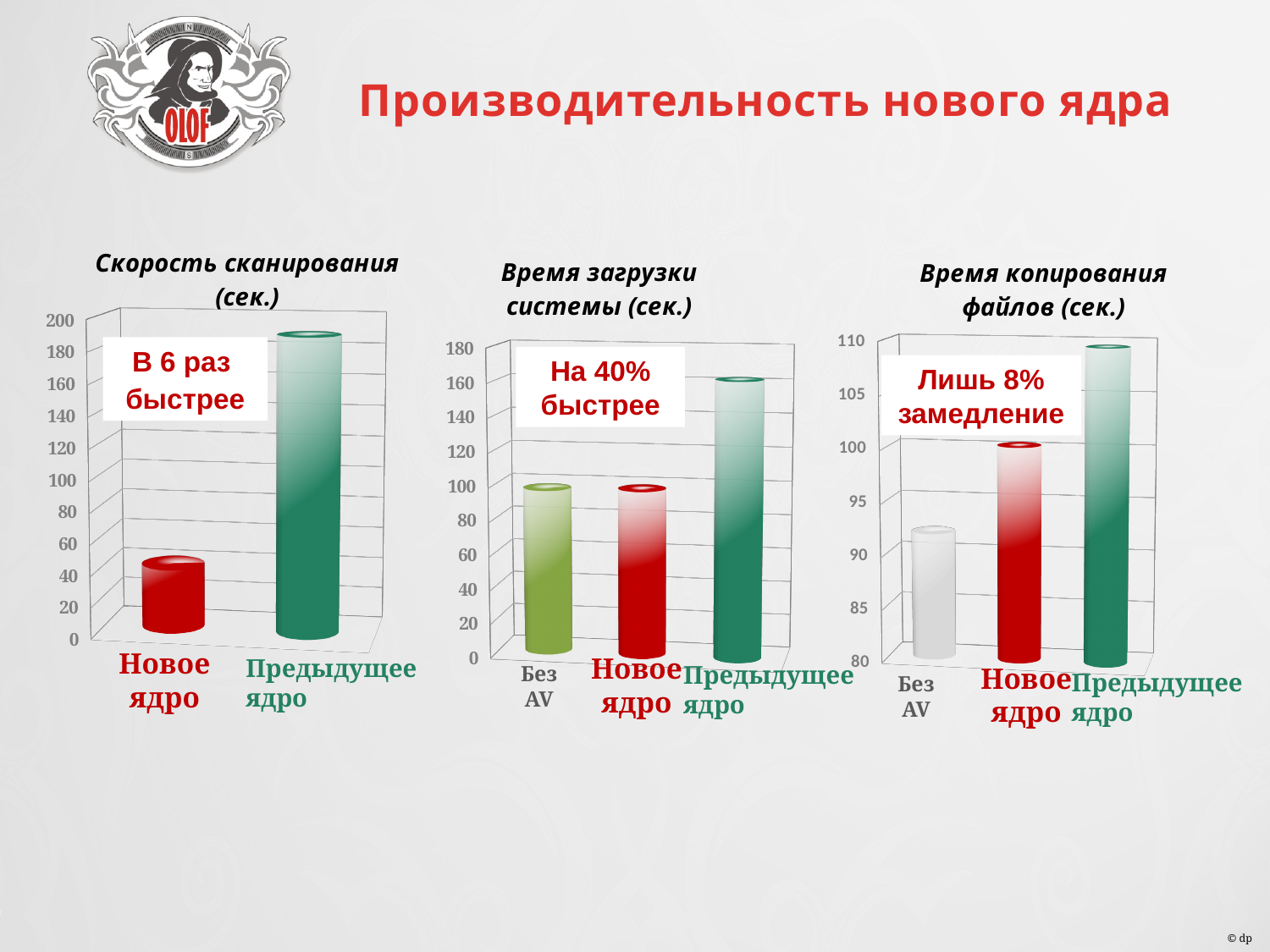
In the 'Время загрузки системы (сек.)' chart, is the value for Без AV greater or less than 140? less In the 'Время копирования файлов (сек.)' chart, which is larger: Новое ядро or Без AV? Новое ядро In the 'Скорость сканирования (сек.)' chart, which category has the highest value? Предыдущее ядро What kind of chart is the 'Скорость сканирования (сек.)' chart? bar chart In the 'Время загрузки системы (сек.)' chart, which category has the highest value? Предыдущее ядро What text is written in the callout box on the 'Скорость сканирования (сек.)' chart? В 6 раз быстрее In the 'Скорость сканирования (сек.)' chart, is the value for Новое ядро greater or less than 100? less How many categories are shown in the 'Время загрузки системы (сек.)' chart? 3 In the 'Скорость сканирования (сек.)' chart, is the value for Предыдущее ядро greater or less than 140? greater How many categories are shown in the 'Скорость сканирования (сек.)' chart? 2 In the 'Время копирования файлов (сек.)' chart, which category has the lowest value? Без AV